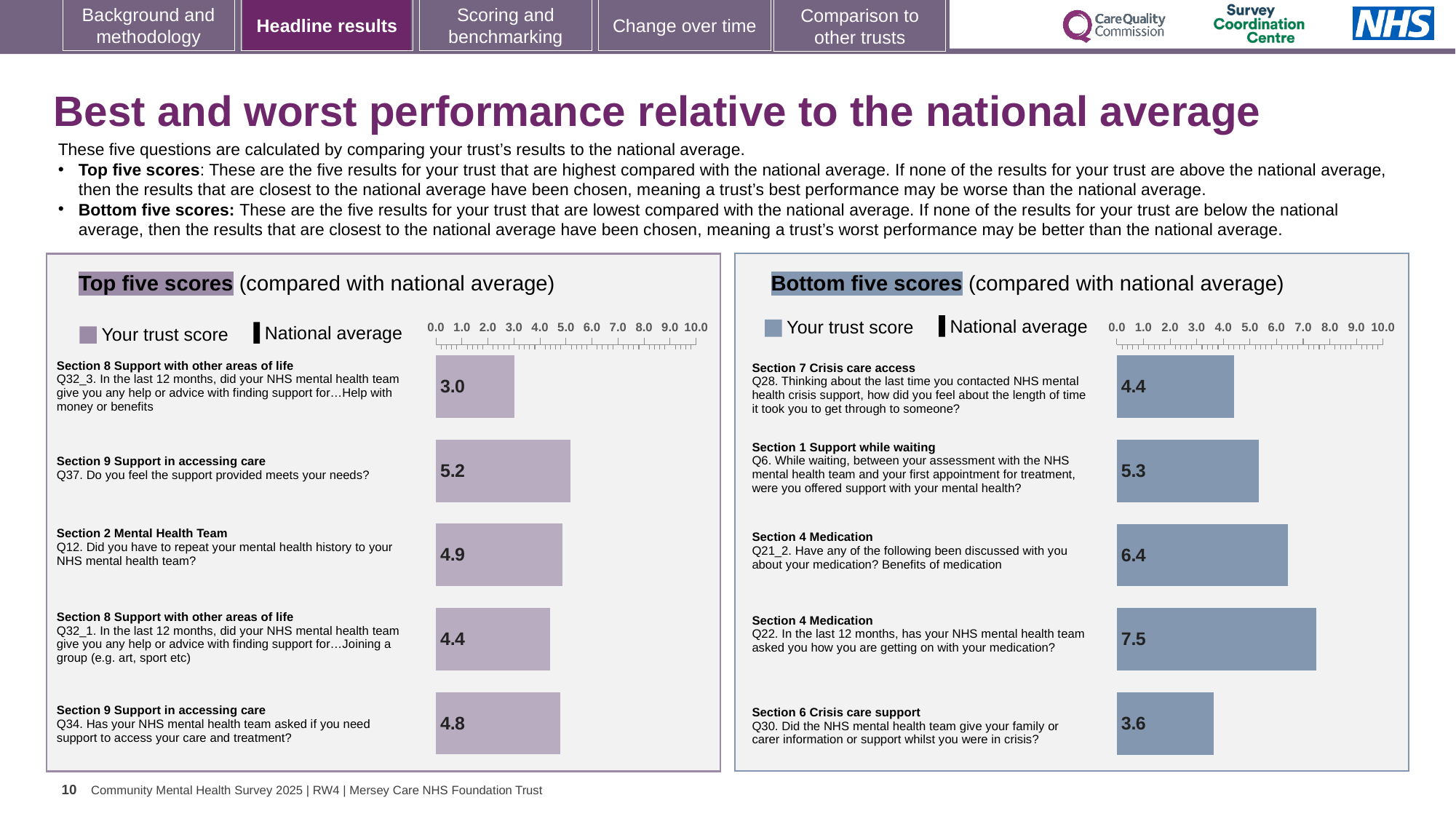
In the Bottom five scores chart, what is the trust score for Q22 (has your NHS mental health team asked you how you are getting on with your medication?)? 7.5 How many questions are plotted in the Bottom five scores chart? 5 In the Bottom five scores chart, what is the trust score for Q21_2 (Benefits of medication)? 6.4 What type of chart is the Top five scores chart? bar chart In the Bottom five scores chart, which question has the highest trust score? Q22 In the Top five scores chart, which question has the highest trust score? Q37 In the Top five scores chart, is the trust score for Q32_1 (Joining a group) greater or less than 5.0? less In the Top five scores chart, what is the difference between the trust scores for Q37 and Q32_3? 2.2 In the Top five scores chart, what is the trust score for Q37 (Do you feel the support provided meets your needs?)? 5.2 In the Bottom five scores chart, what is the difference between the trust scores for Q22 and Q30? 3.9 In the Bottom five scores chart, which question has the lowest trust score? Q30 In the Top five scores chart, which question has the lowest trust score? Q32_3